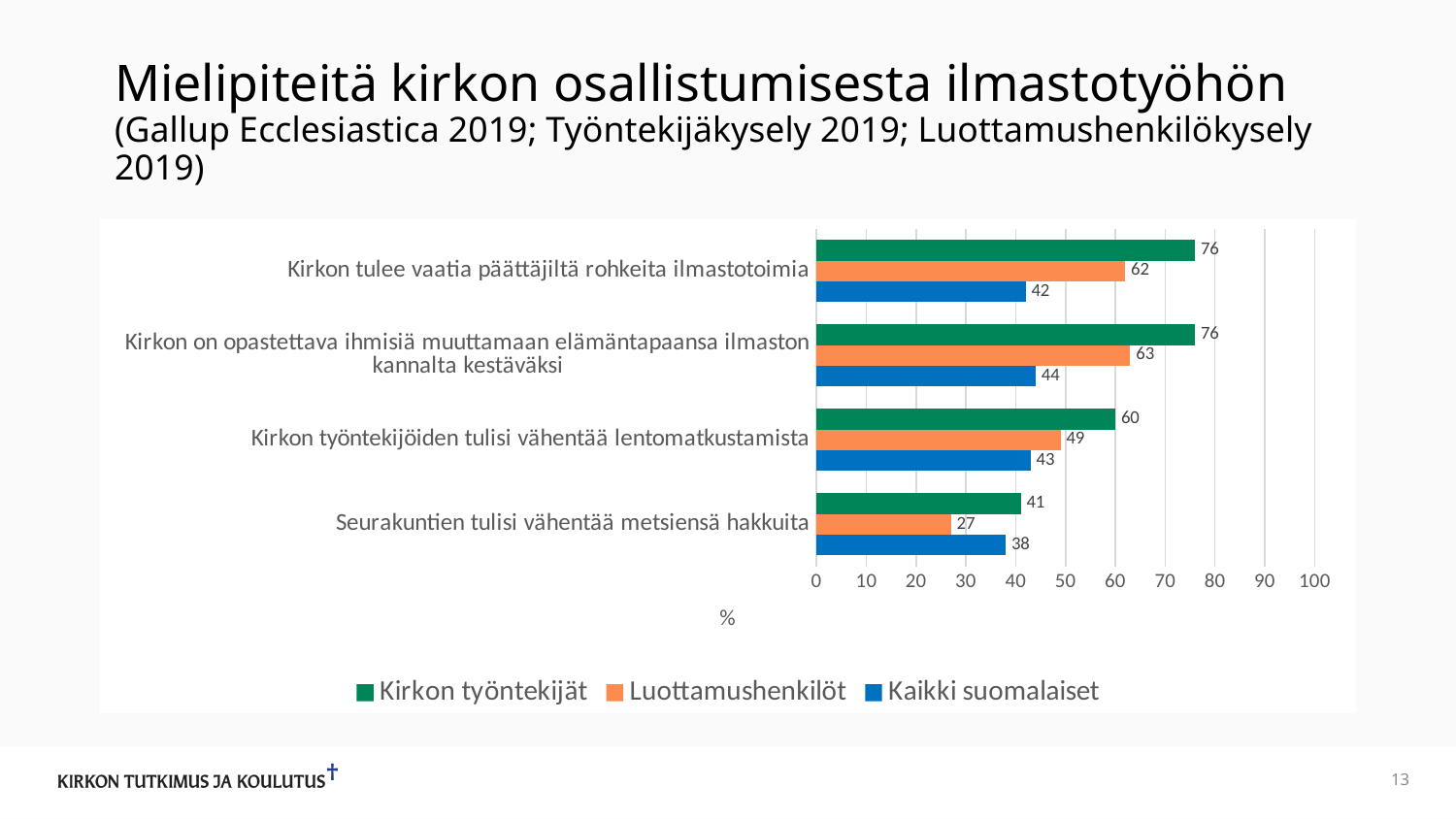
On "Seurakuntien tulisi vähentää metsiensä hakkuita", which is larger: Luottamushenkilöt or Kaikki suomalaiset? Kaikki suomalaiset What is the value for Luottamushenkilöt on "Kirkon työntekijöiden tulisi vähentää lentomatkustamista"? 49 How many series does the legend list? 3 What is the value for Kaikki suomalaiset on "Seurakuntien tulisi vähentää metsiensä hakkuita"? 38 Which colour represents Luottamushenkilöt in the chart? orange What is the difference between Kirkon työntekijät and Kaikki suomalaiset on "Kirkon tulee vaatia päättäjiltä rohkeita ilmastotoimia"? 34 What kind of chart is shown on the slide? bar chart What is the value for Kirkon työntekijät on "Kirkon tulee vaatia päättäjiltä rohkeita ilmastotoimia"? 76 Which statement has the lowest value for Luottamushenkilöt? Seurakuntien tulisi vähentää metsiensä hakkuita How many statements (categories) are shown in the chart? 4 Is the value for Kirkon työntekijät on "Kirkon työntekijöiden tulisi vähentää lentomatkustamista" greater or less than 50? greater Which statement has the highest value for Kaikki suomalaiset? Kirkon on opastettava ihmisiä muuttamaan elämäntapaansa ilmaston kannalta kestäväksi